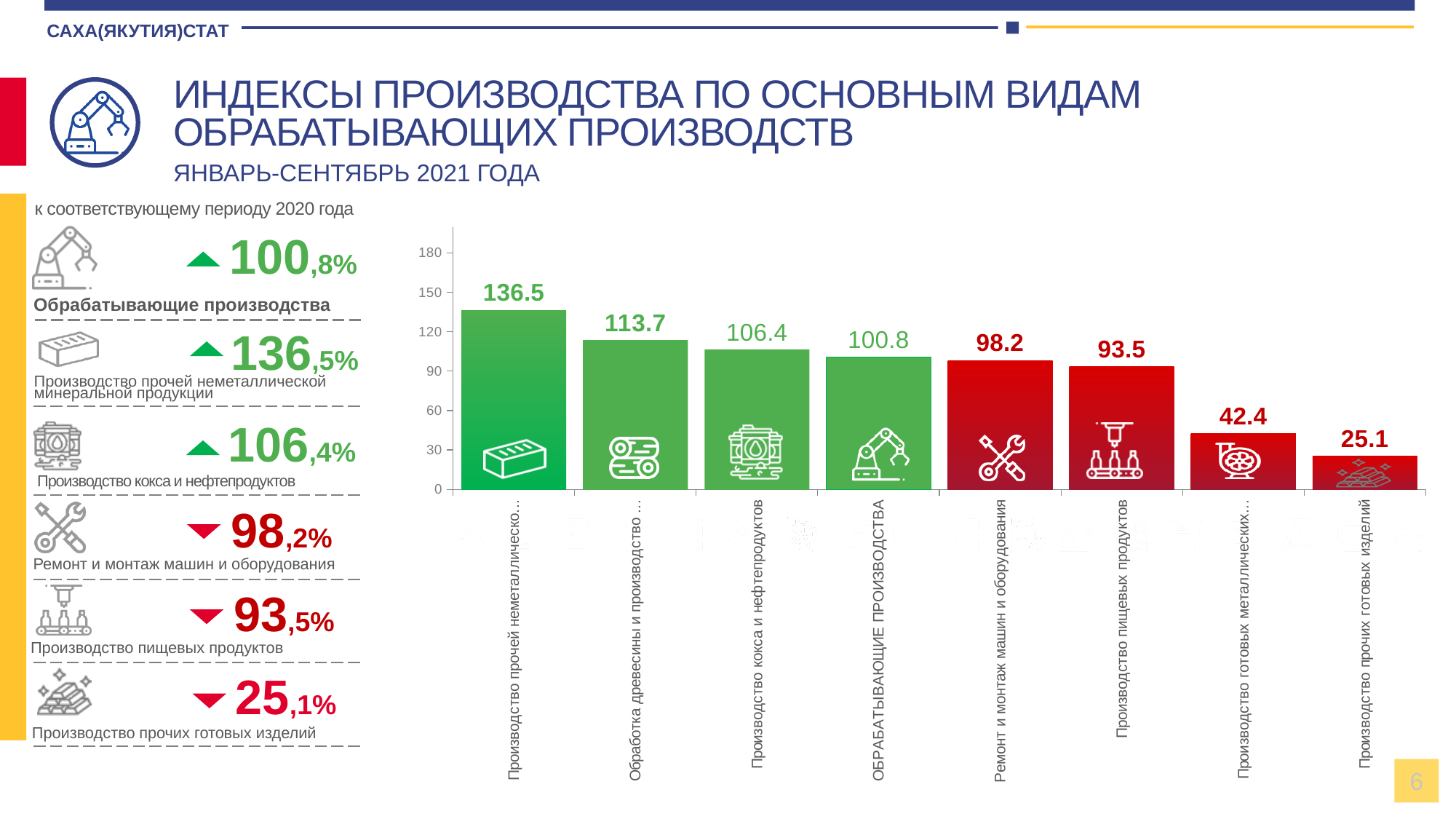
What colour are the bars with values below 100? red What is the value for Производство пищевых продуктов? 93.5 Which category has the lowest value in the chart? Производство прочих готовых изделий What is the value for Производство кокса и нефтепродуктов? 106.4 What is the difference between the values for Производство пищевых продуктов and Производство прочих готовых изделий? 68.4 What type of chart is shown on the slide? bar chart How many bars does the chart contain? 8 Which category has the highest value in the chart? Производство прочей неметаллической минеральной продукции Which is larger: the value for Производство кокса и нефтепродуктов or the value for Ремонт и монтаж машин и оборудования? Производство кокса и нефтепродуктов What is the value for Ремонт и монтаж машин и оборудования? 98.2 What is the value for ОБРАБАТЫВАЮЩИЕ ПРОИЗВОДСТВА? 100.8 Do the bar values rise or fall from left to right along the x axis? fall